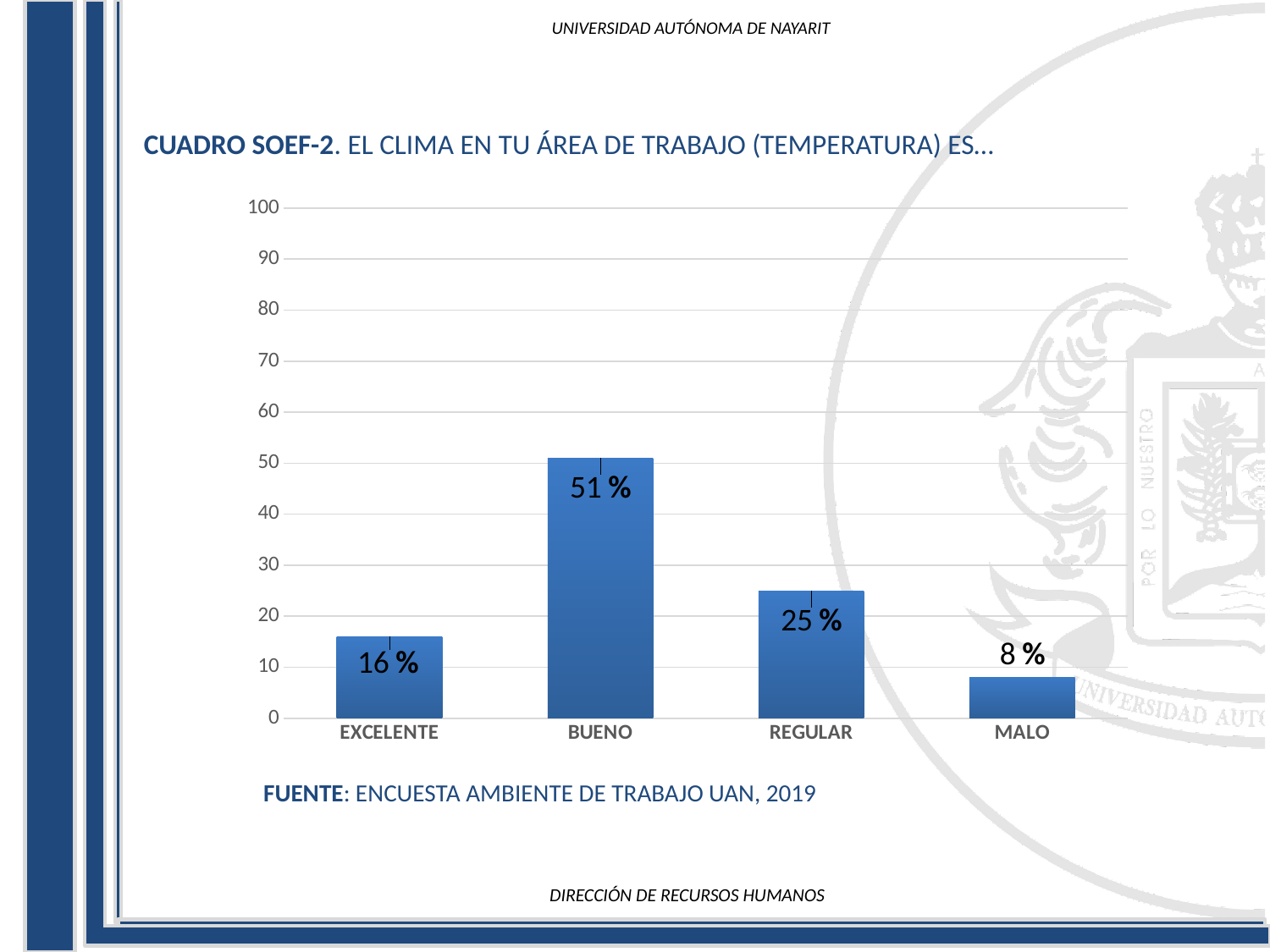
What kind of chart is shown on the slide? bar chart What is the source cited below the chart? ENCUESTA AMBIENTE DE TRABAJO UAN, 2019 How many categories are shown on the x axis? 4 What is the value for BUENO? 51 % Is the value for BUENO greater or less than 40? greater What is the value for EXCELENTE? 16 % Which category has the lowest value? MALO What is the value for REGULAR? 25 % What is the value for MALO? 8 % Which category has the highest value? BUENO What is the difference between the values for BUENO and REGULAR? 26 % Which is larger, the value for EXCELENTE or the value for REGULAR? REGULAR